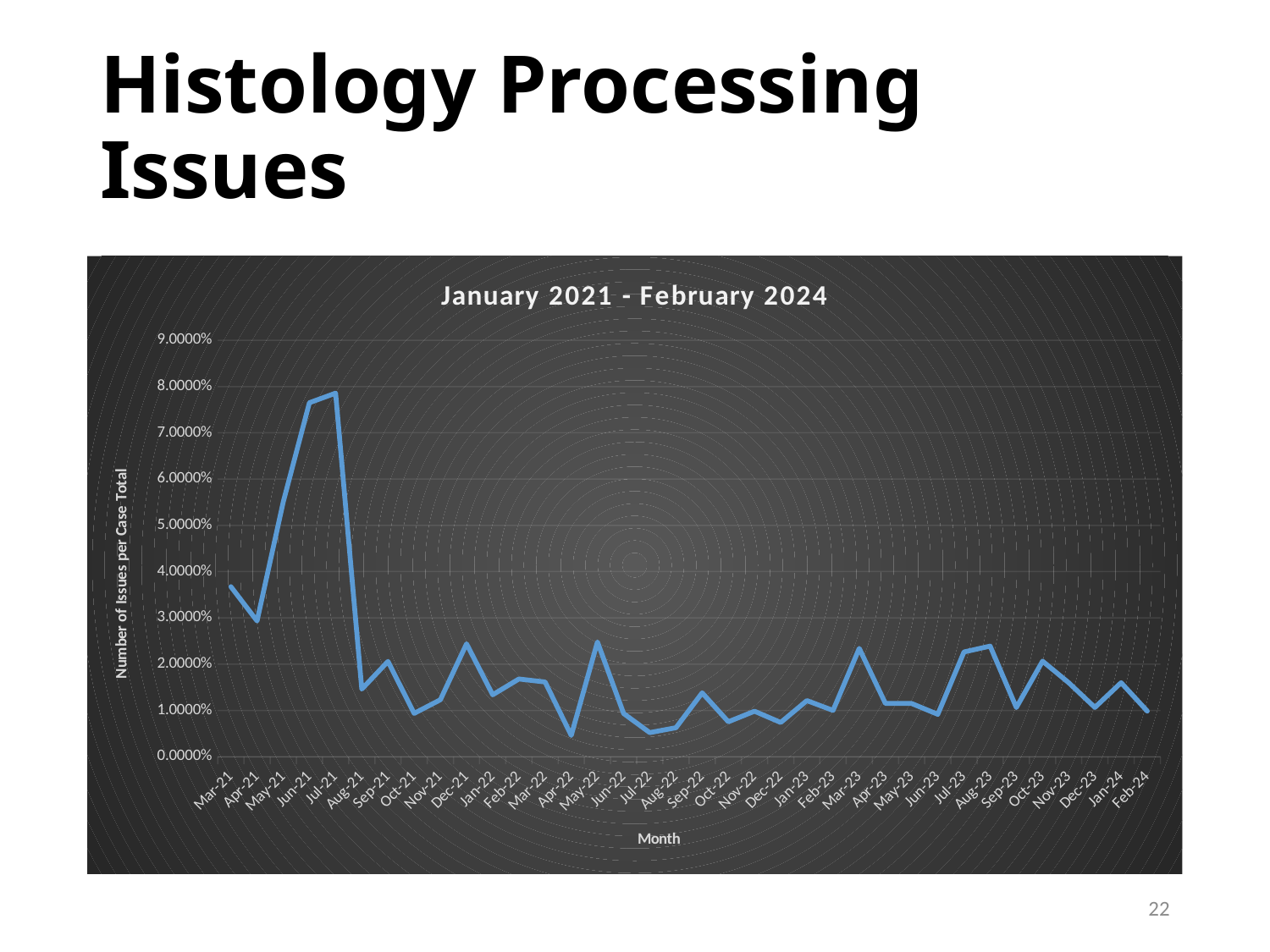
Which is larger, the value for Mar-21 or the value for Apr-21? Mar-21 What is the title of the chart? January 2021 - February 2024 Which is larger, the value for Jun-21 or the value for Aug-21? Jun-21 Which month has the highest value on the chart? Jul-21 Do the values rise or fall from Apr-21 to Jul-21? rise Is the value for Aug-21 greater or less than 2.0000%? less Is the value for Jul-21 greater or less than 7.0000%? greater What kind of chart is shown on the slide? line chart What is the label on the vertical axis of the chart? Number of Issues per Case Total Is the value for Jul-22 greater or less than 1.0000%? less How many months are plotted along the x axis of the chart? 36